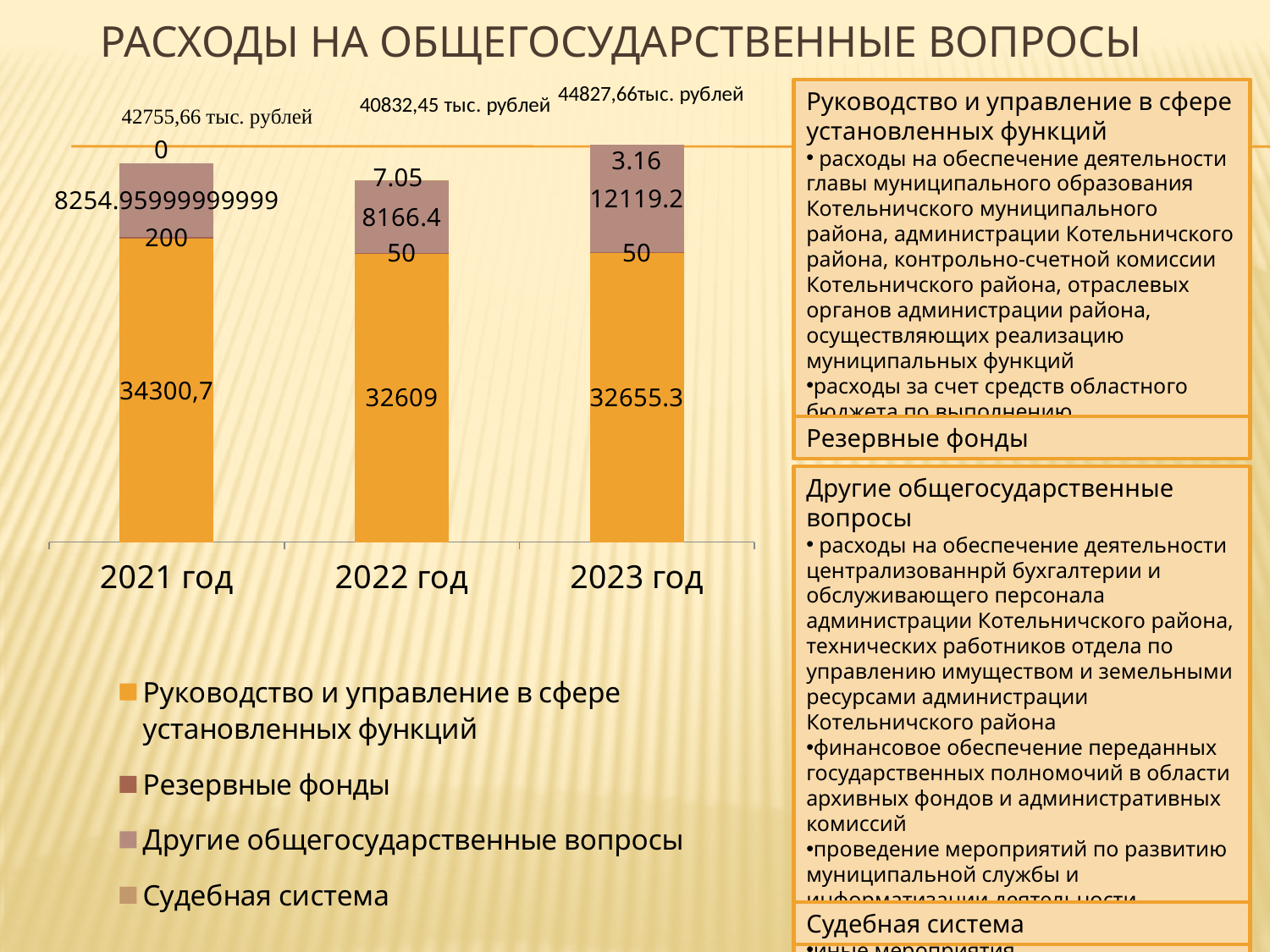
What is the value of 'Судебная система' for 2022 год? 7.05 What is the value of 'Руководство и управление в сфере установленных функций' for 2021 год? 34300,7 What is the value of 'Руководство и управление в сфере установленных функций' for 2022 год? 32609 How many years (categories) are shown on the x axis of the chart? 3 What type of chart is shown on the slide? Stacked bar chart How many series does the chart legend list? 4 What is the value of 'Другие общегосударственные вопросы' for 2023 год? 12119.2 What is the value of 'Резервные фонды' for 2021 год? 200 What is the total expenditure shown above the bar for 2023 год? 44827,66 тыс. рублей Which is larger: the 'Резервные фонды' value for 2021 год or for 2022 год? 2021 год What is the difference between the 'Другие общегосударственные вопросы' values for 2023 год and 2022 год? 3952.8 In which year is the value of 'Руководство и управление в сфере установленных функций' the highest? 2021 год